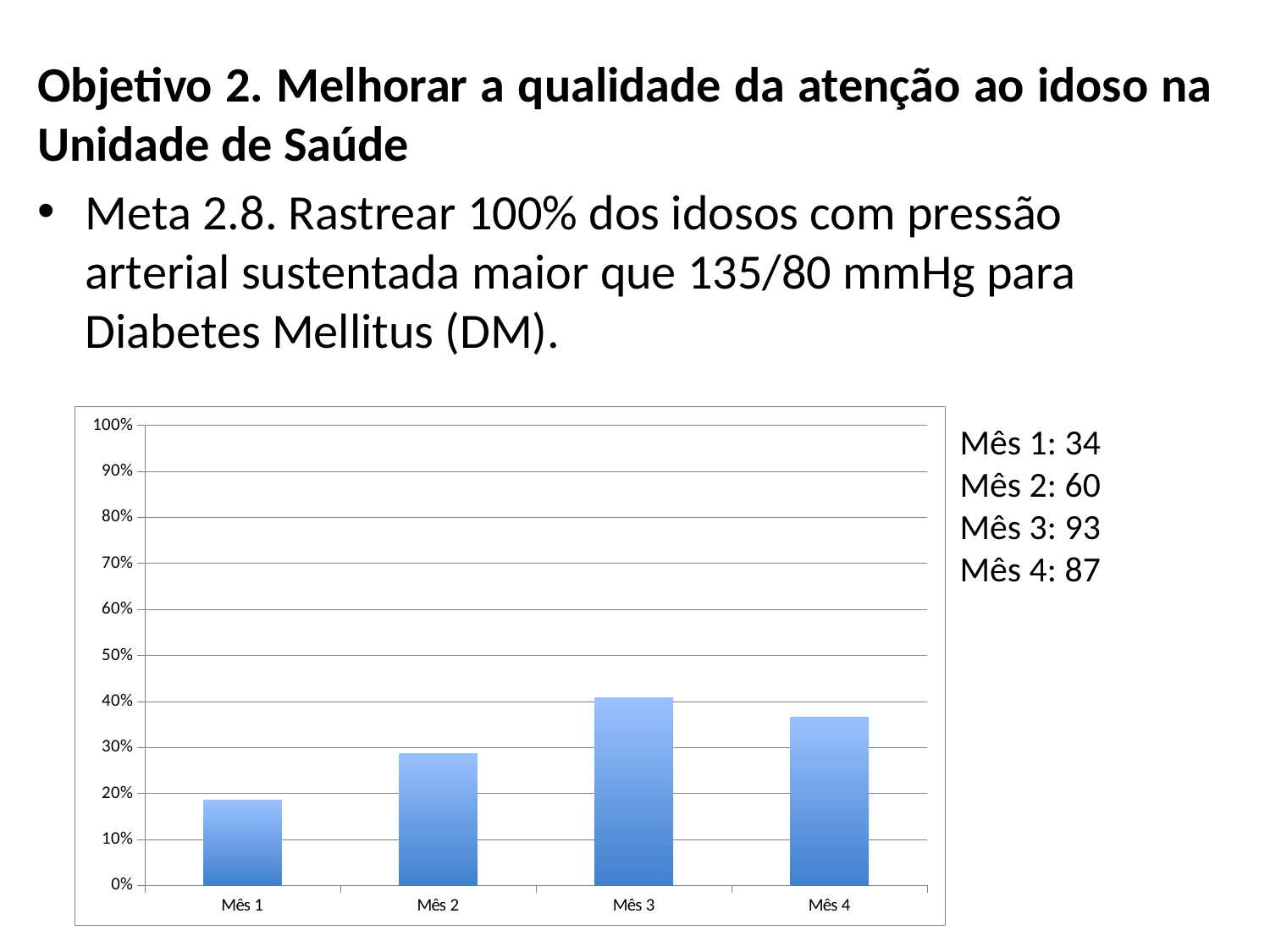
What kind of chart is shown on the slide? bar chart Is the value for Mês 4 greater or less than 50%? less How do the values change from Mês 1 to Mês 4 in the chart? They rise from Mês 1 to Mês 3, then fall at Mês 4 How many categories (months) are plotted on the x axis of the chart? 4 Is the value for Mês 1 greater or less than 30%? less Which month has the highest bar in the chart? Mês 3 Which month has the lowest bar in the chart? Mês 1 What is the highest value shown on the chart's vertical axis? 100% Is the value for Mês 2 greater or less than 40%? less Which bar is taller, Mês 3 or Mês 4? Mês 3 Which bar is taller, Mês 1 or Mês 2? Mês 2